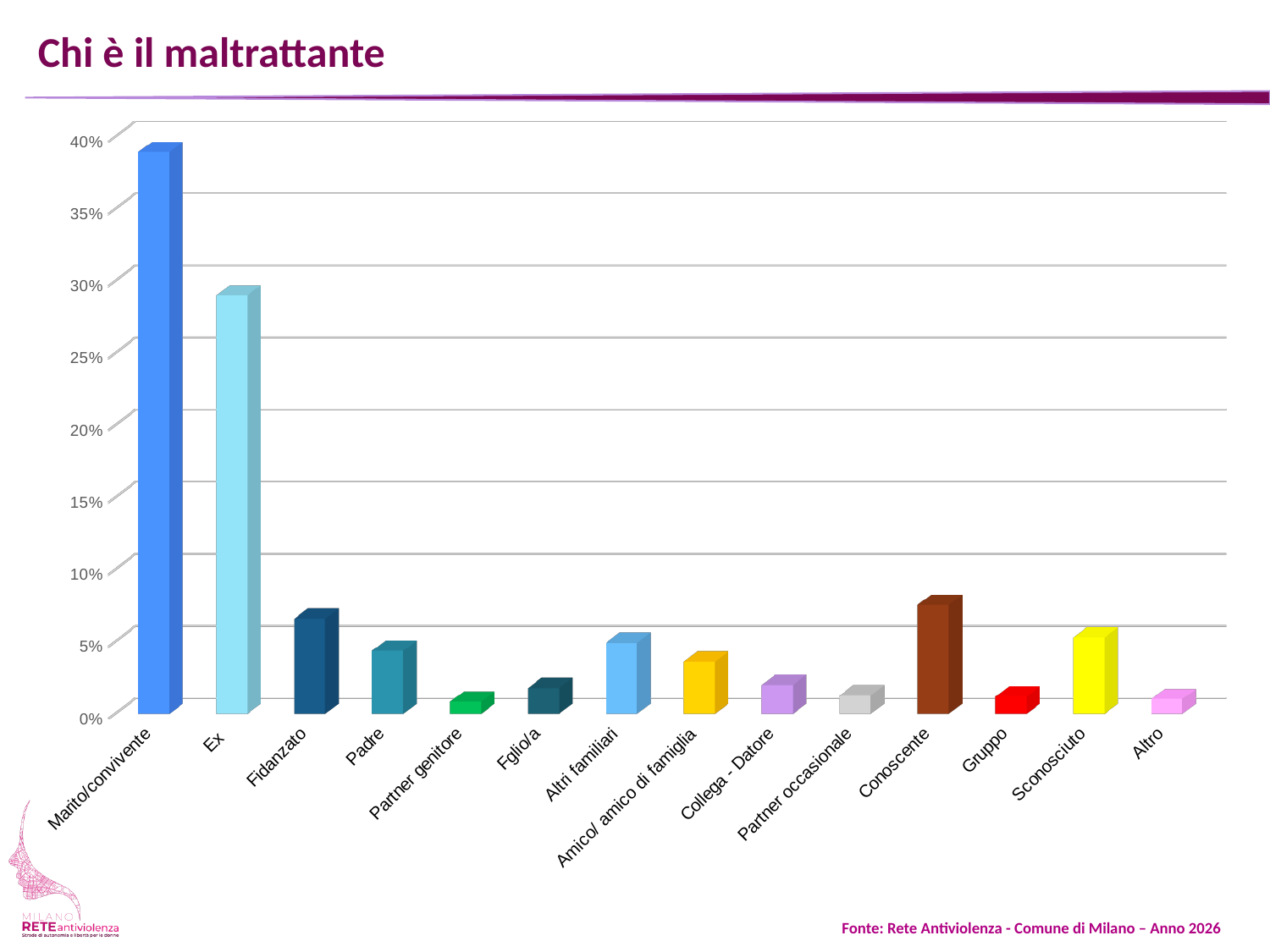
Is the value for Ex greater or less than 25%? greater How many categories are shown on the x axis of the chart? 14 Is the value for Altro greater or less than 5%? less Which is larger, the value for Ex or the value for Fidanzato? Ex Is the value for Marito/convivente greater or less than 35%? greater What is the title of the slide containing the chart? Chi è il maltrattante Which is larger, the value for Conoscente or the value for Padre? Conoscente Which category has the highest value in the chart? Marito/convivente What kind of chart is shown on the slide? bar chart